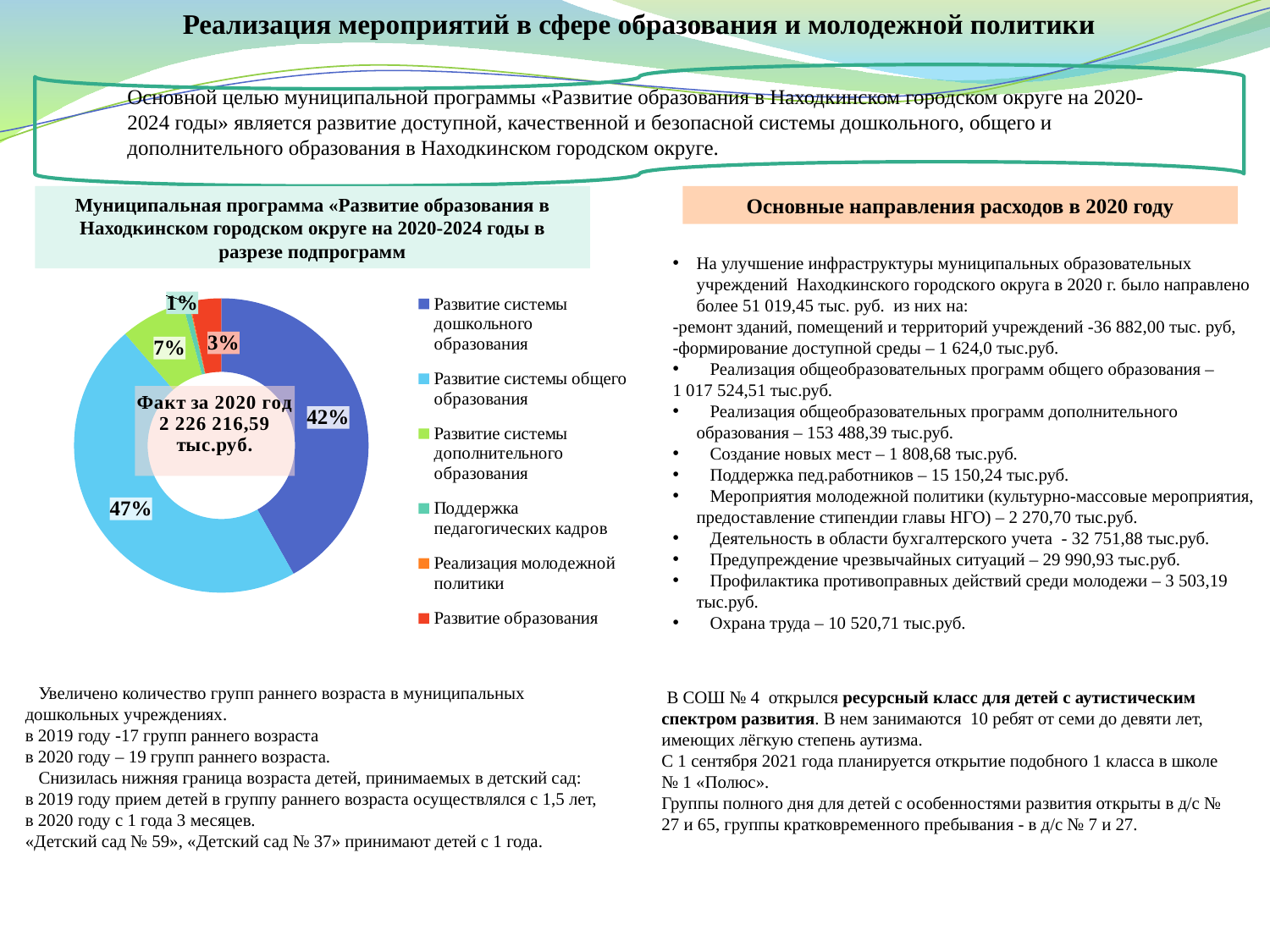
What share of the pie chart is labelled for «Развитие системы общего образования»? 47% What total amount is printed in the centre of the pie chart for «Факт за 2020 год»? 2 226 216,59 тыс.руб. Which subprogram has the largest share in the pie chart? Развитие системы общего образования By how many percentage points does the share for «Развитие системы дошкольного образования» exceed the share for «Развитие системы дополнительного образования»? 35 How many entries does the legend of the pie chart list? 6 What share of the pie chart is labelled for «Развитие системы дополнительного образования»? 7% What share of the pie chart is labelled for «Развитие системы дошкольного образования»? 42% By how many percentage points does the share for «Развитие системы общего образования» exceed the share for «Развитие системы дошкольного образования»? 5 What share of the pie chart is labelled for «Развитие образования»? 3% Which legend entry of the pie chart is shown in light blue? Развитие системы общего образования What kind of chart is shown on the slide? Doughnut chart Which is larger in the pie chart: the share for «Развитие системы дошкольного образования» or for «Развитие системы общего образования»? Развитие системы общего образования